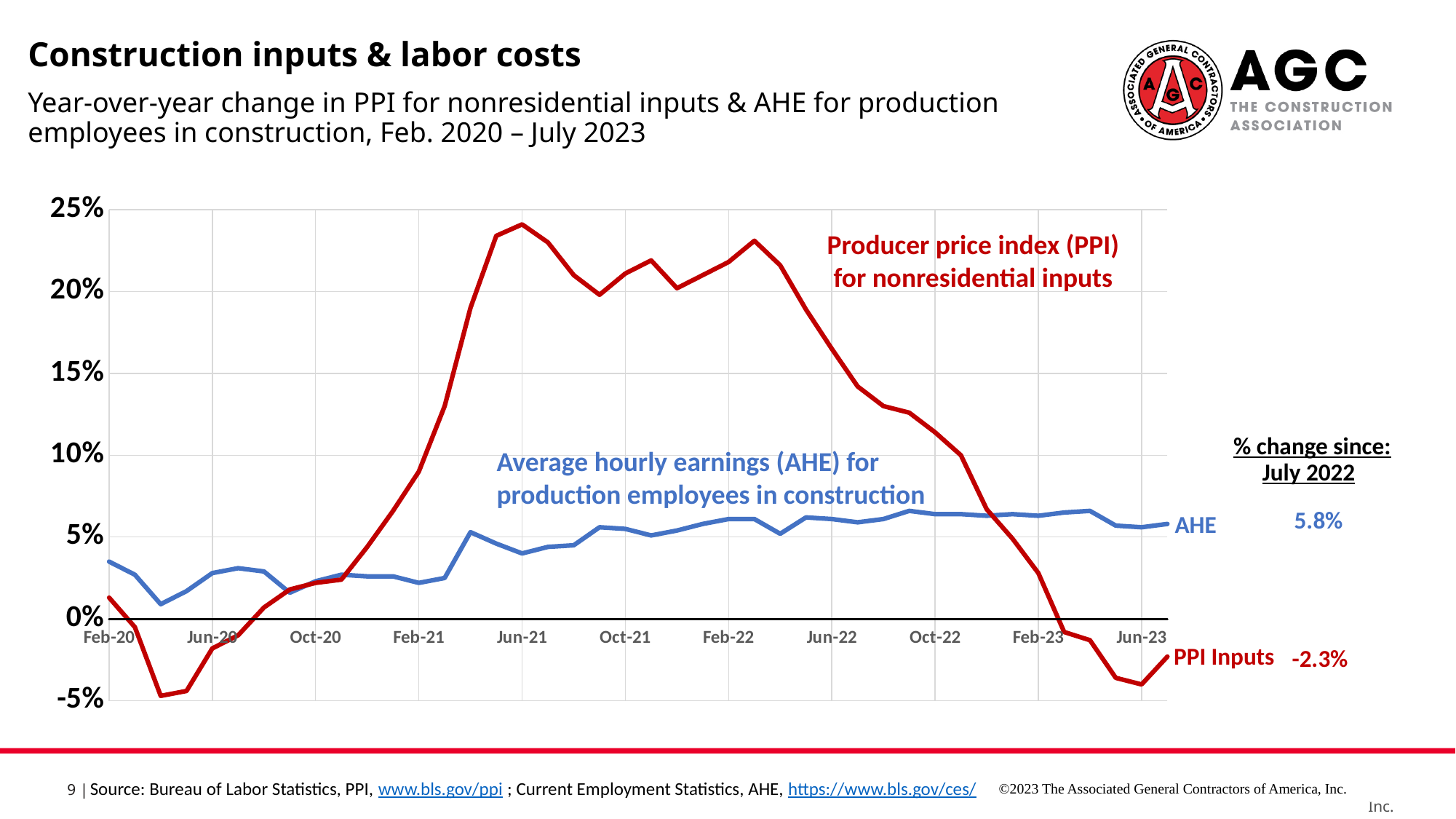
Is the PPI for nonresidential inputs value at Jun-20 greater or less than 0%? less What is the % change since July 2022 shown for PPI Inputs? -2.3% What kind of chart is shown on the slide? line chart Does the PPI for nonresidential inputs line rise or fall from Jun-22 to Jun-23? fall Which series reaches the highest value on the chart? Producer price index (PPI) for nonresidential inputs What is the % change since July 2022 shown for AHE? 5.8% What is the difference between the AHE and PPI Inputs % change since July 2022 values? 8.1 percentage points Is the PPI for nonresidential inputs value at Jun-21 greater or less than 20%? greater How many data series are plotted on the chart? 2 Which series has the larger % change since July 2022, AHE or PPI Inputs? AHE Is the PPI for nonresidential inputs value at Jun-22 greater or less than 10%? greater